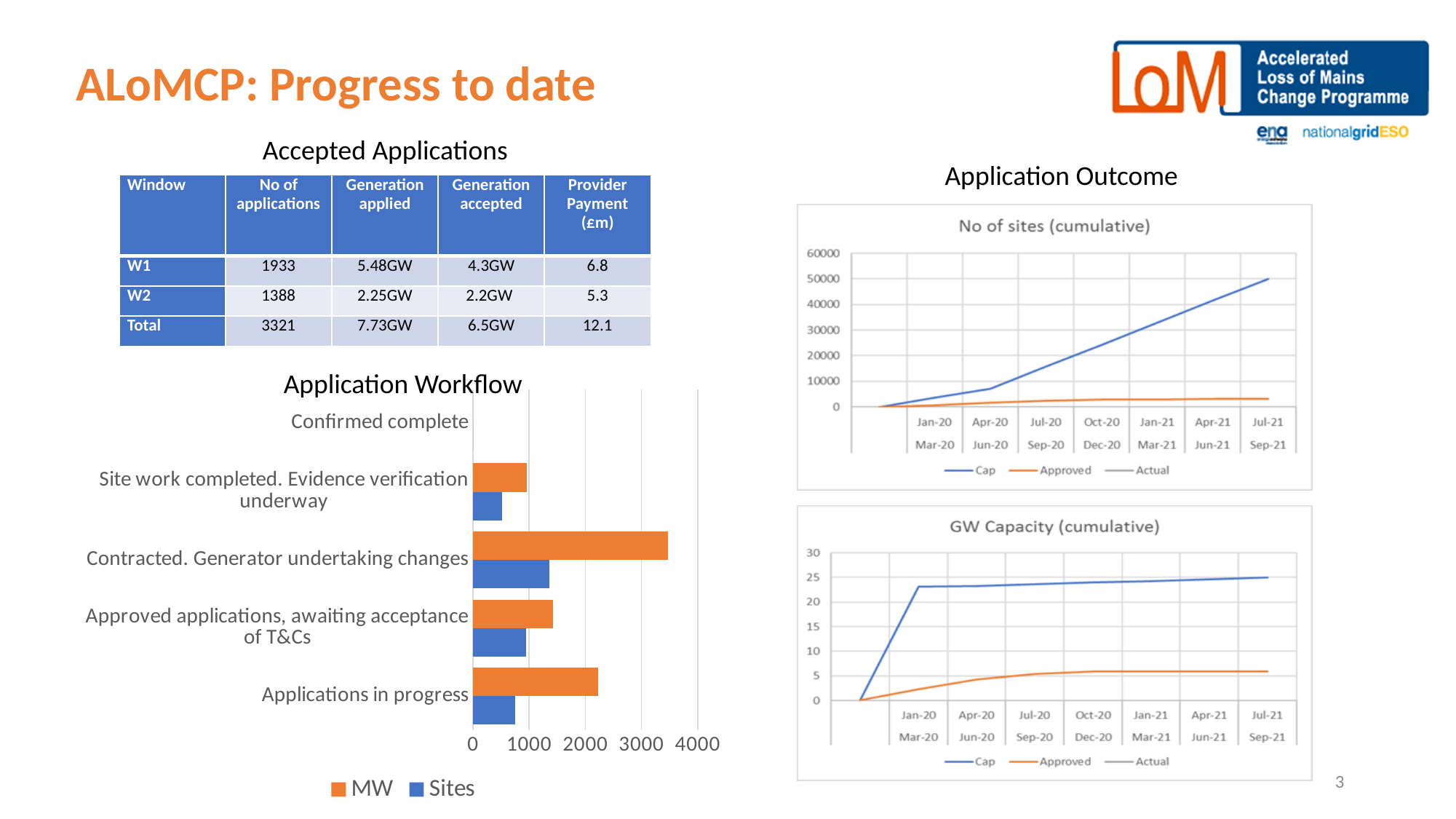
In the 'GW Capacity (cumulative)' chart, is the Approved value at Sep-21 greater or less than 5? greater How many series does the legend of the Application Workflow chart list? 2 In the Application Workflow chart, is the Sites value for 'Site work completed. Evidence verification underway' greater or less than 1000? less How many categories are shown on the Application Workflow chart? 5 In the 'No of sites (cumulative)' chart, does the Cap series rise or fall over time? rise In the Application Workflow chart, is the MW value for 'Applications in progress' greater or less than 2000? greater What kind of chart is the 'No of sites (cumulative)' chart? line chart In the Application Workflow chart, which is larger for 'Approved applications, awaiting acceptance of T&Cs': MW or Sites? MW In the Application Workflow chart, which category has the highest MW value? Contracted. Generator undertaking changes How many series does the legend of the 'GW Capacity (cumulative)' chart list? 3 What kind of chart is the Application Workflow chart? bar chart